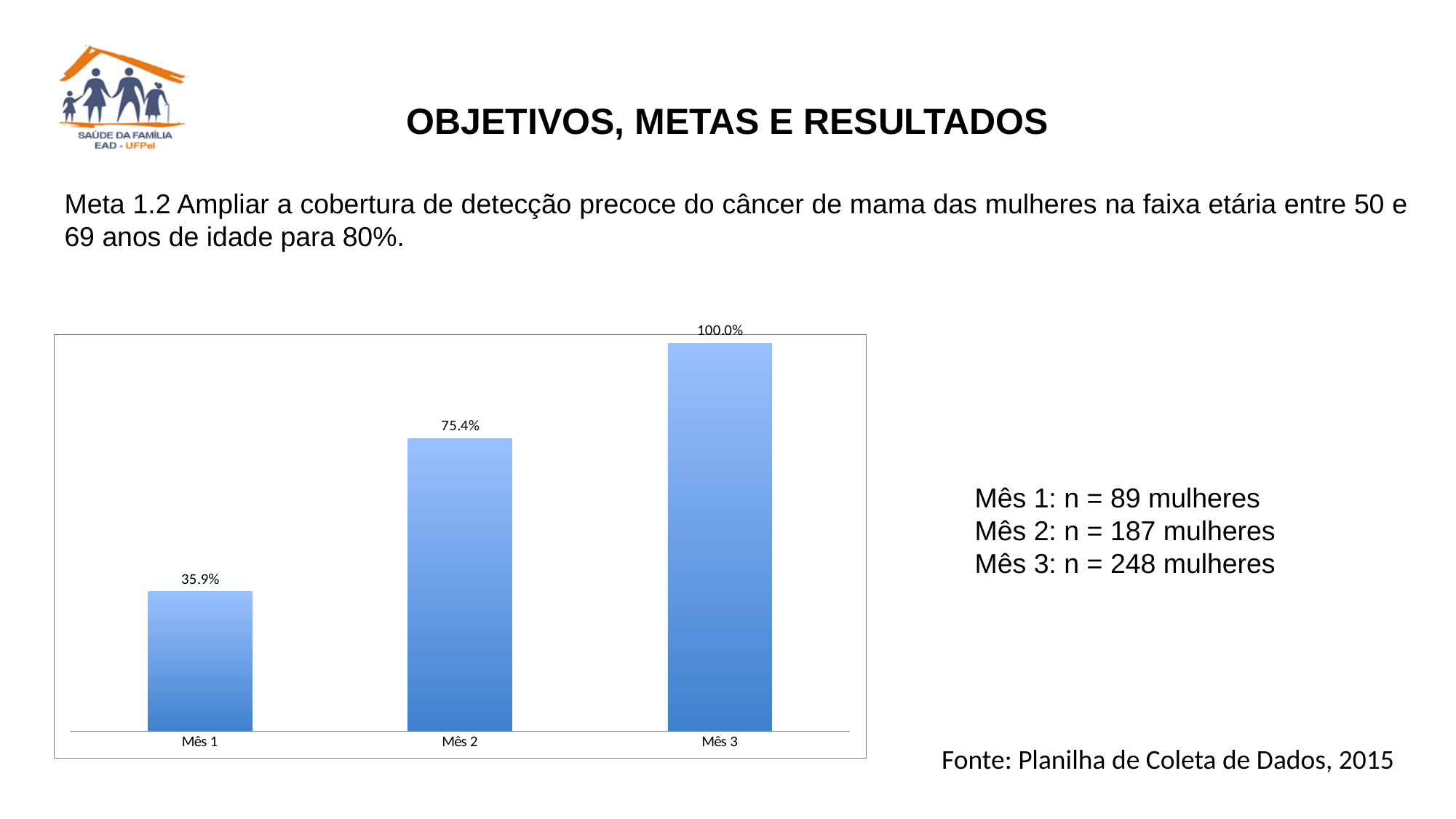
What is the value for Mês 2? 75.4% What is the value for Mês 1? 35.9% Which month has the lowest value? Mês 1 What is the difference between the values for Mês 2 and Mês 1? 39.5% What colour are the bars in the chart? Blue Which month has the highest value? Mês 3 What kind of chart is shown on the slide? Bar chart Which is larger, the value for Mês 1 or the value for Mês 2? Mês 2 What is the difference between the values for Mês 3 and Mês 2? 24.6% What is the value for Mês 3? 100.0% How many categories are shown on the x axis of the chart? 3 Do the values rise or fall from Mês 1 to Mês 3? Rise